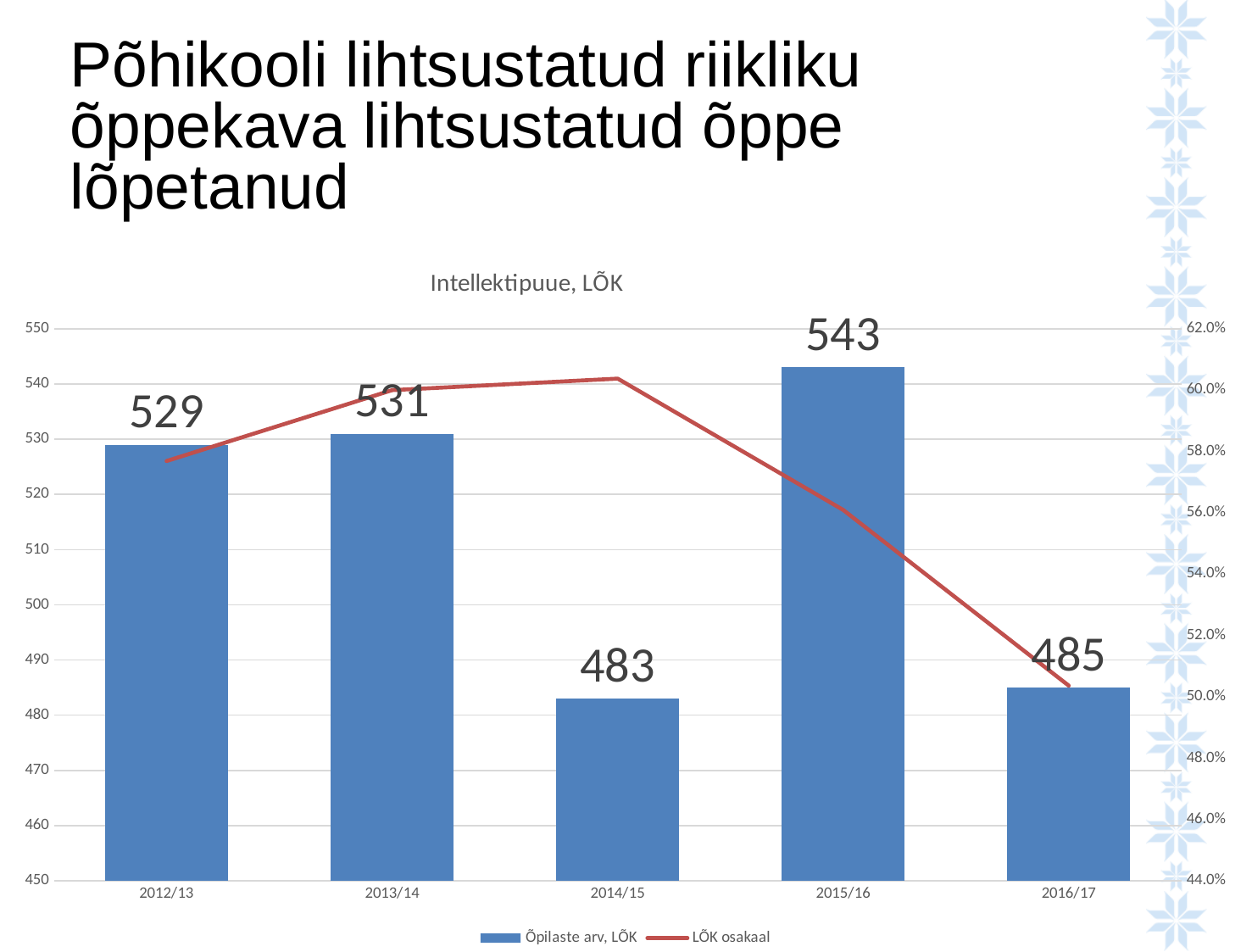
What is the title of the chart? Intellektipuue, LÕK Is the LÕK osakaal value for 2016/17 greater or less than 52.0%? less Which is larger, the Õpilaste arv, LÕK value for 2013/14 or for 2016/17? 2013/14 Is the LÕK osakaal value for 2014/15 greater or less than 58.0%? greater What is the value of Õpilaste arv, LÕK for 2015/16? 543 How many years are shown on the x axis? 5 Which year has the highest Õpilaste arv, LÕK? 2015/16 How many series does the legend list? 2 What is the difference between the Õpilaste arv, LÕK values for 2015/16 and 2014/15? 60 Which year has the lowest Õpilaste arv, LÕK? 2014/15 What is the value of Õpilaste arv, LÕK for 2012/13? 529 What is the value of Õpilaste arv, LÕK for 2014/15? 483